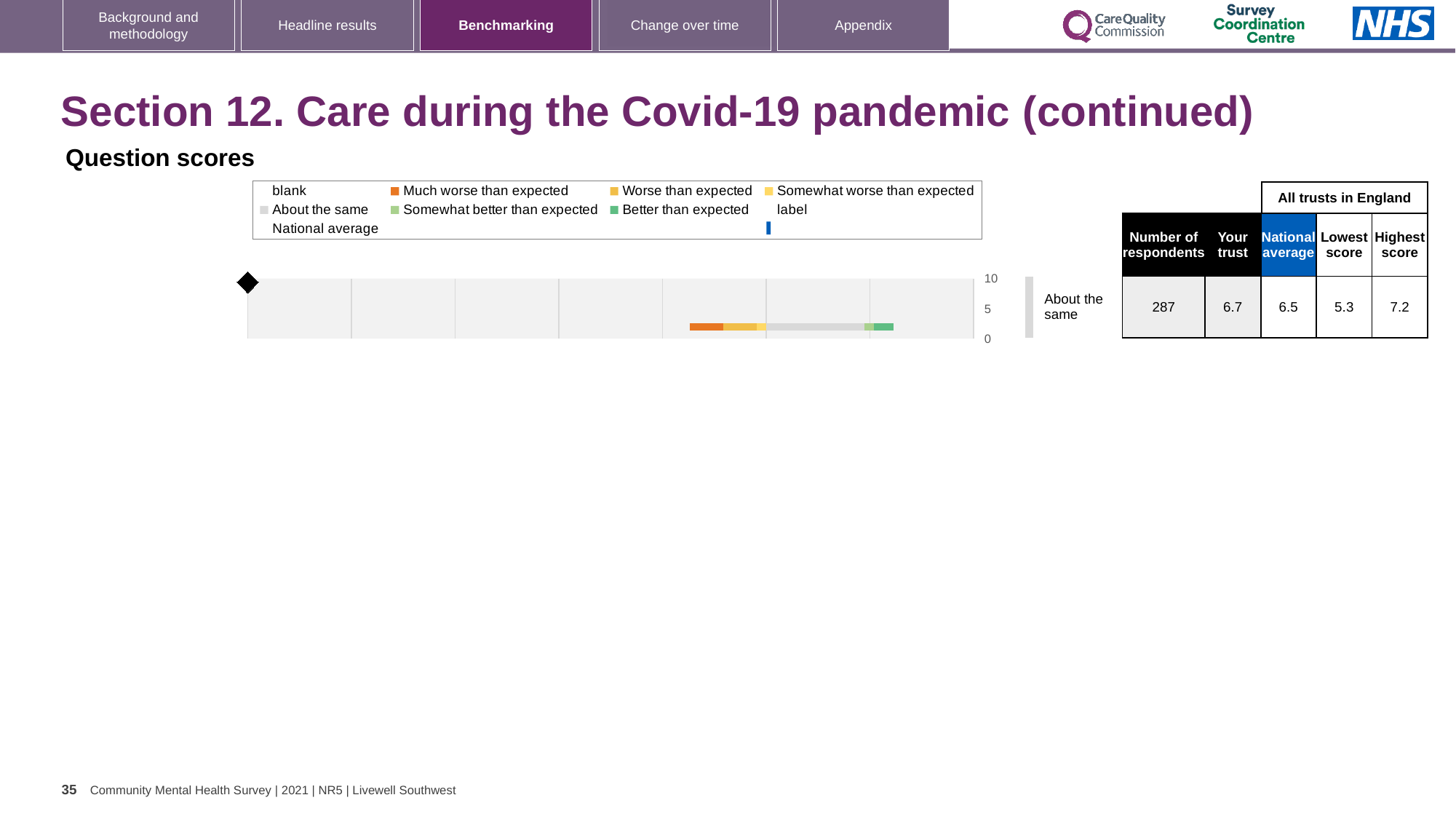
What is the difference between the Your trust score and the National average score? 0.2 What is the Lowest score among all trusts in England? 5.3 How is the trust's result for this question categorised relative to expectations? About the same What is the maximum value shown on the chart's score axis? 10 What kind of chart is used to show the question score on this slide? bar chart What is the National average score shown next to the chart? 6.5 What is the difference between the Highest score and the Lowest score? 1.9 How many respondents are recorded for this question? 287 How many question bars are plotted in the chart? 1 What is the score for Your trust shown next to the chart? 6.7 What is the Highest score among all trusts in England? 7.2 Which is larger, the Your trust score or the National average score? Your trust